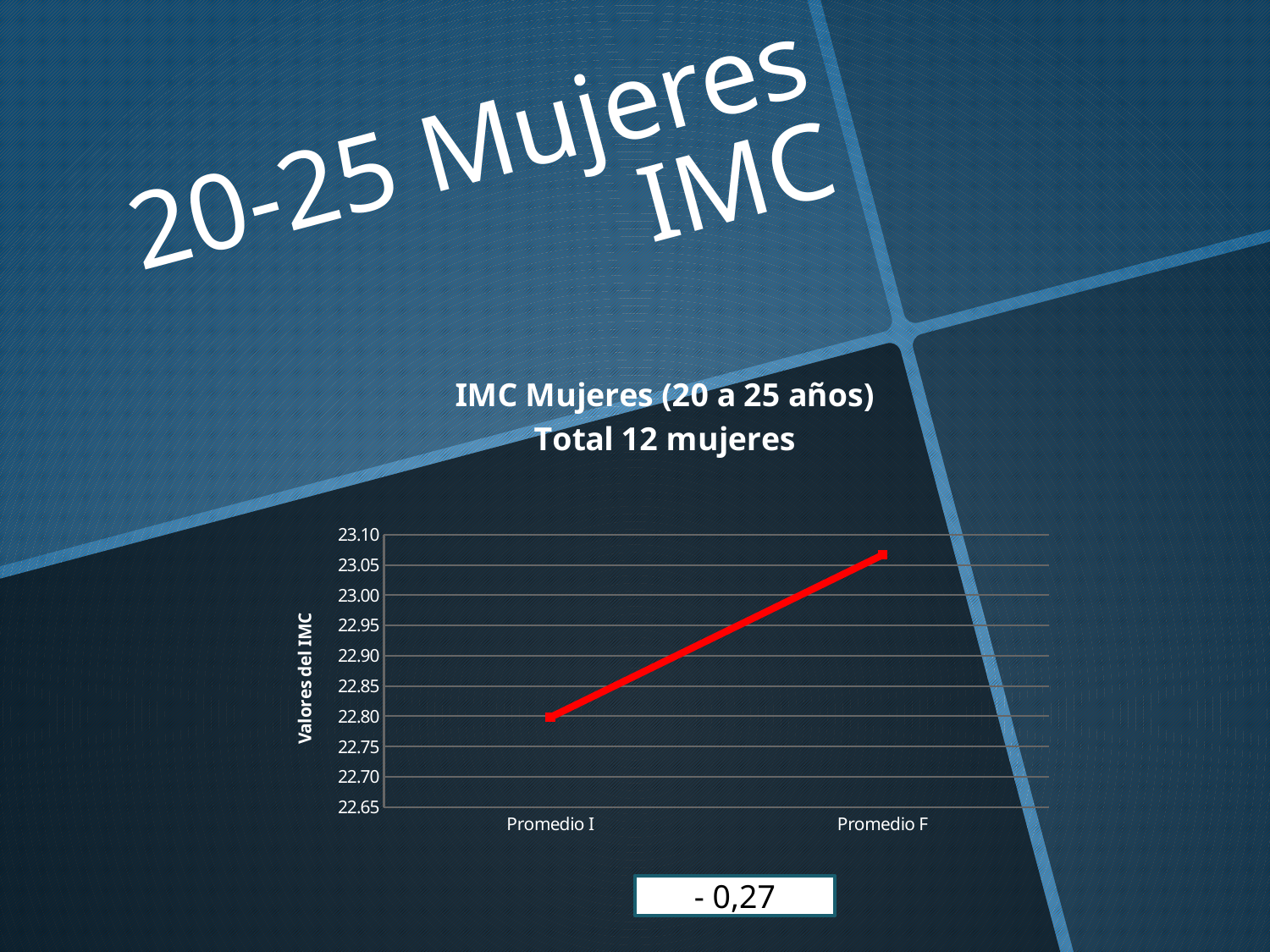
Does the line rise or fall from Promedio I to Promedio F? rise What is the title of the chart? IMC Mujeres (20 a 25 años) Total 12 mujeres What kind of chart is shown on the slide? line chart How many data points are plotted on the line? 2 Which category has the lowest value on the chart? Promedio I What is the label of the vertical axis? Valores del IMC Which category has the higher IMC value, Promedio I or Promedio F? Promedio F Which category has the highest value on the chart? Promedio F Is the value for Promedio F greater or less than 23.00? greater Is the value for Promedio I greater or less than 22.90? less